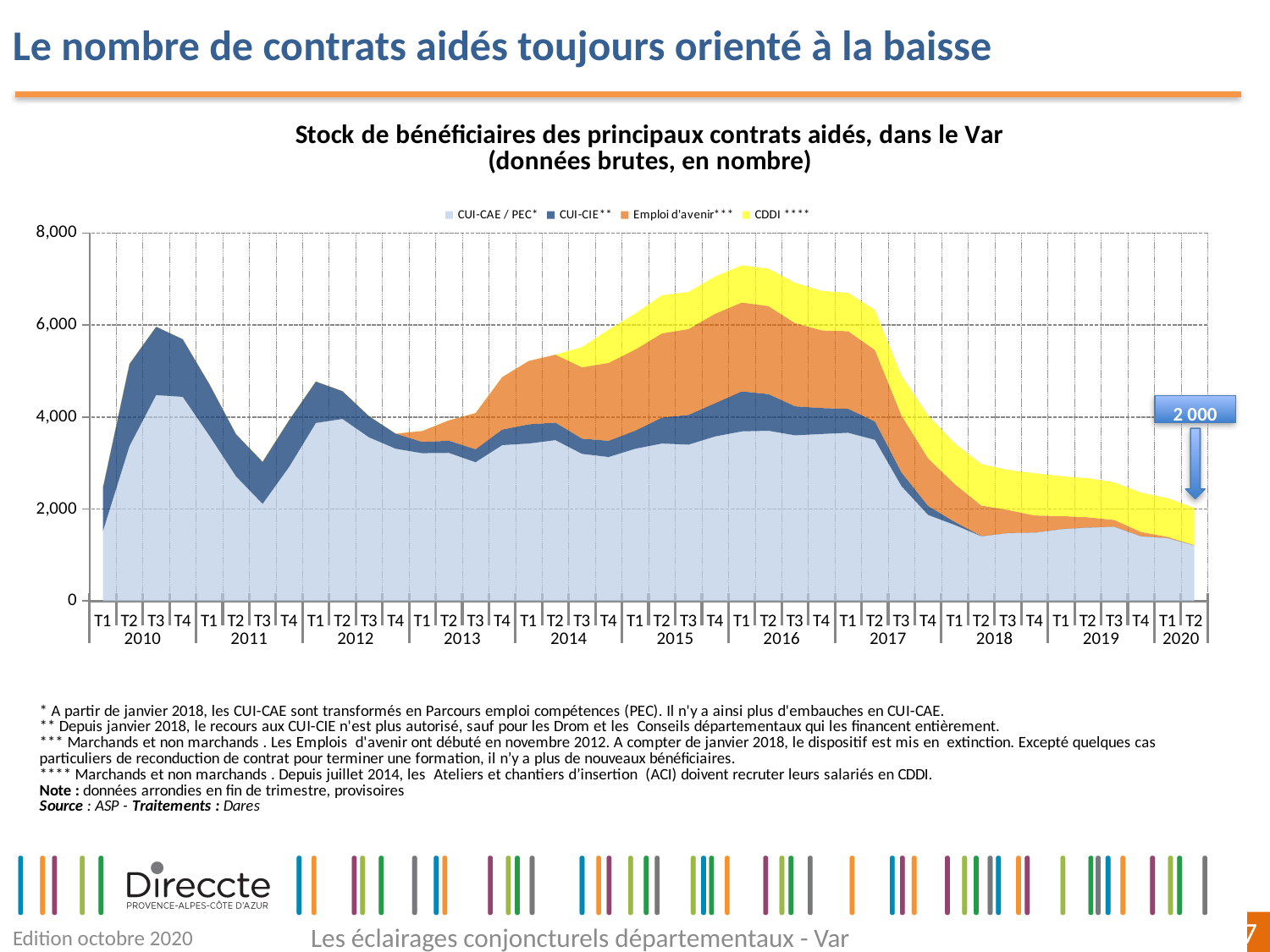
What kind of chart is shown on the slide? Stacked area chart What is the title of the chart? Stock de bénéficiaires des principaux contrats aidés, dans le Var (données brutes, en nombre) How many series does the chart legend list? 4 Which series is shown in yellow in the chart? CDDI **** Which is larger, the total stock in T1 2016 or in T2 2020? T1 2016 How many quarterly points are plotted along the x axis (T1 2010 to T2 2020)? 42 In which quarter does the total stock of beneficiaries reach its highest level? T1 2016 Is the total stock of beneficiaries in T2 2020 greater or less than 4,000? less What value does the callout annotation give for the last point (T2 2020)? 2 000 Does the total stock of beneficiaries rise or fall between 2016 and 2020? Fall Is the total stock of beneficiaries in T1 2016 greater or less than 6,000? greater Is the total stock of beneficiaries in T1 2010 greater or less than 4,000? less